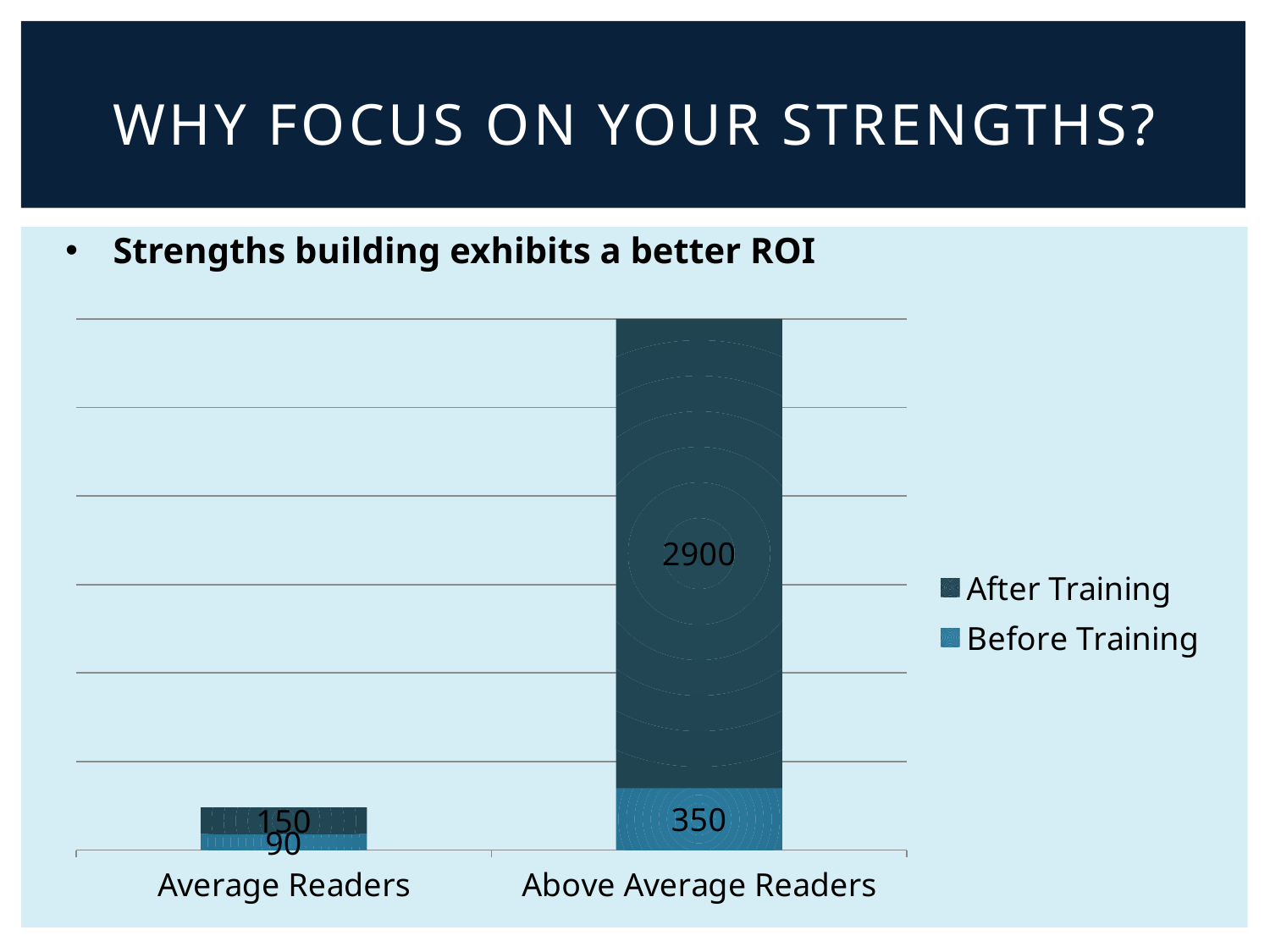
Which category has the higher After Training value? Above Average Readers Which category has the lower Before Training value? Average Readers What is the Before Training value for Above Average Readers? 350 Is the After Training value for Average Readers larger or smaller than the Before Training value for Above Average Readers? smaller What is the After Training value for Above Average Readers? 2900 What is the total of the stacked bar for Above Average Readers? 3250 How many categories are shown on the x axis? 2 What is the difference between the Before Training values for Above Average Readers and Average Readers? 260 What is the difference between the After Training and Before Training values for Above Average Readers? 2550 What is the After Training value for Average Readers? 150 How many series does the legend list? 2 What is the Before Training value for Average Readers? 90